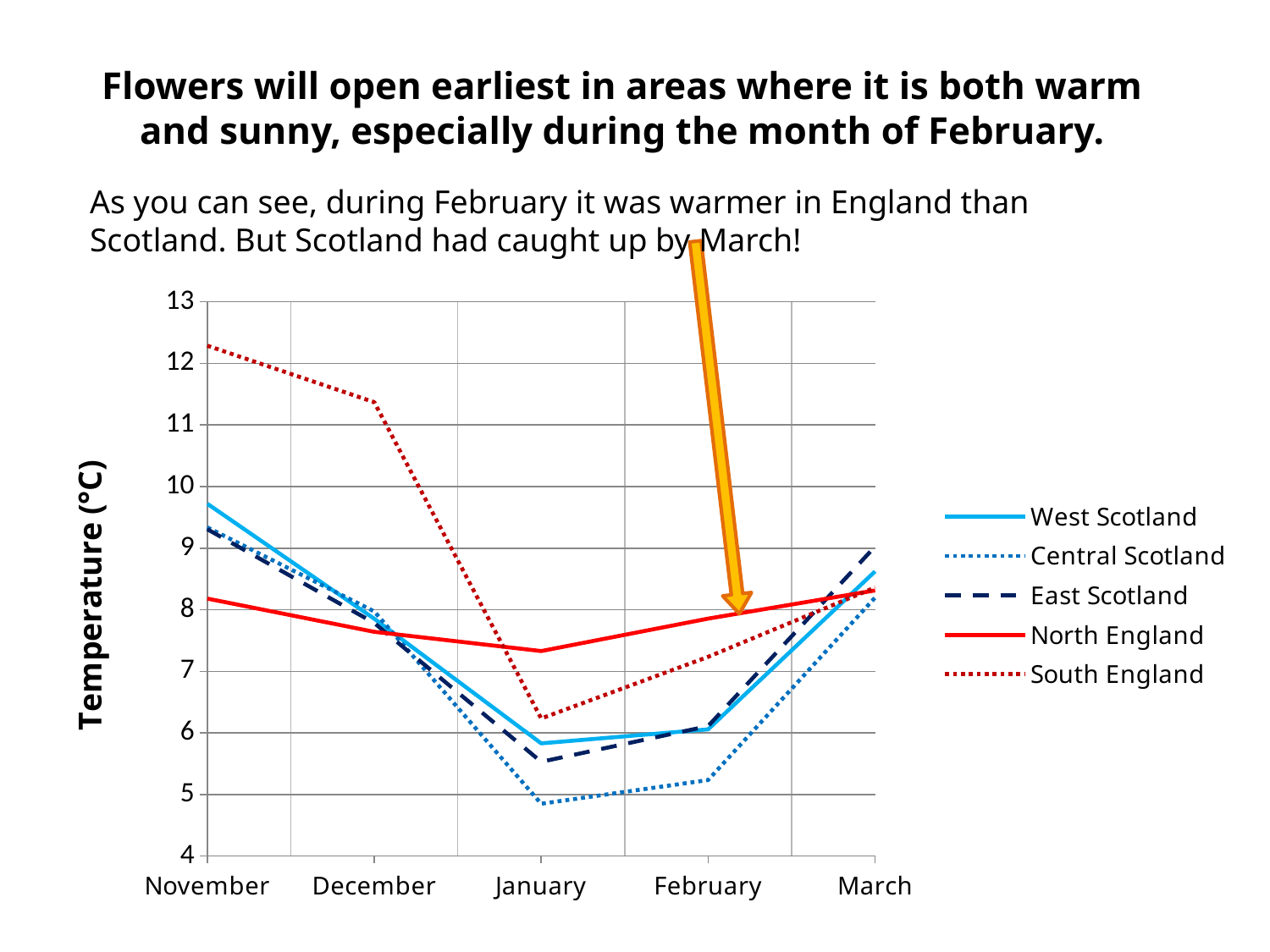
Is the value for North England in January greater or less than 7? greater In which month is the West Scotland temperature lowest? January In February, which is warmer: North England or West Scotland? North England Is the value for South England in November greater or less than 12? greater How many series does the legend list? 5 What kind of chart is shown on the slide? line chart What is the title of the y axis? Temperature (°C) Does the South England line rise or fall from November to January? fall Which series has the highest temperature in November? South England How many months are shown along the x axis? 5 Which series has the lowest temperature in January? Central Scotland Is the value for Central Scotland in January greater or less than 5? less